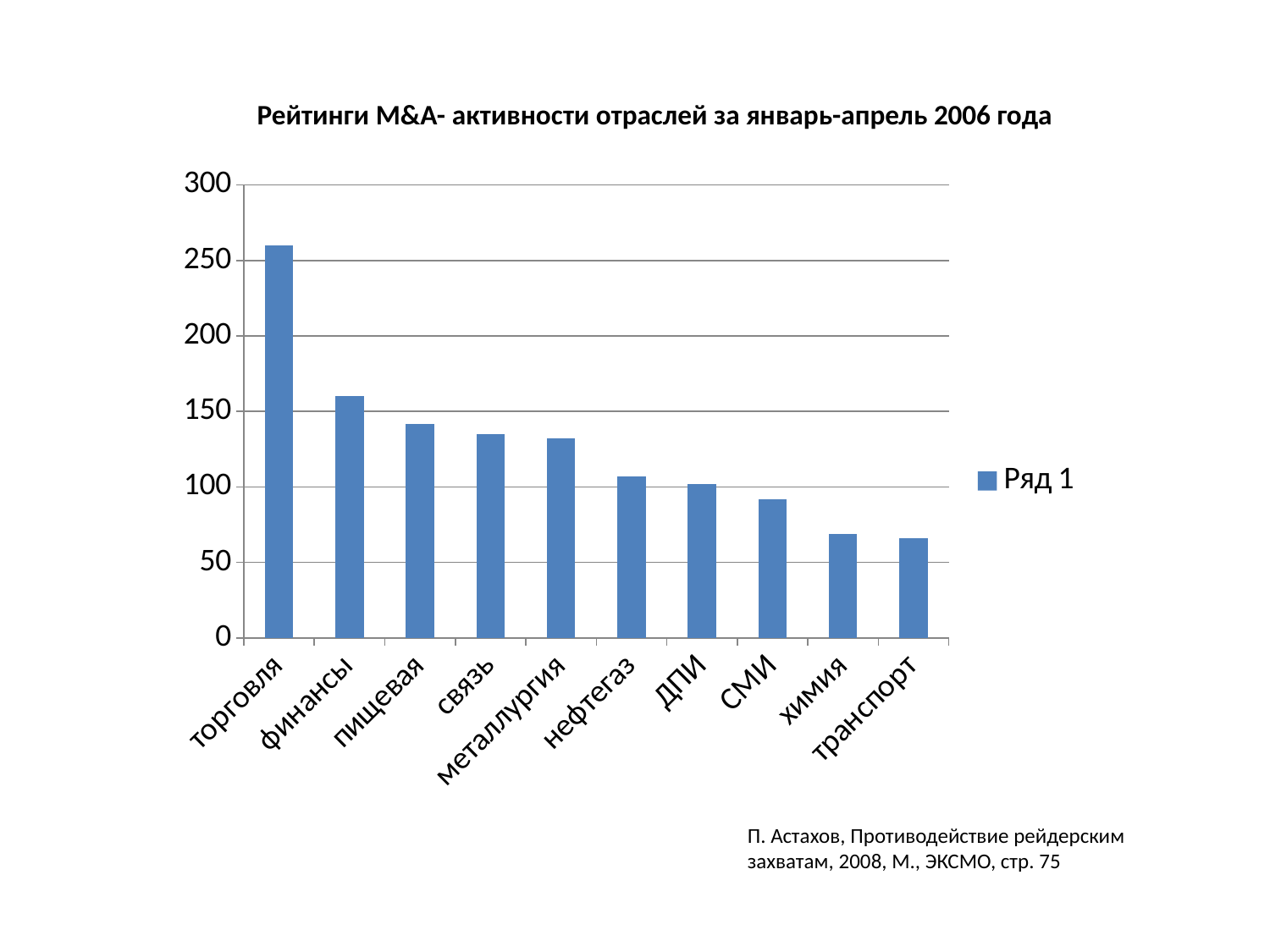
What kind of chart is shown on the slide? bar chart How many series does the legend list? 1 Which industry has the highest M&A activity rating in the chart? торговля Do the values rise or fall moving from left to right along the x axis? fall Which is larger, the value for финансы or the value for нефтегаз? финансы How many industries are shown on the x axis of the chart? 10 Is the value for финансы greater or less than 200? less Which industry has the lowest M&A activity rating in the chart? транспорт What is the title of the chart? Рейтинги M&A- активности отраслей за январь-апрель 2006 года Is the value for СМИ greater or less than 100? less Is the value for торговля greater or less than 250? greater